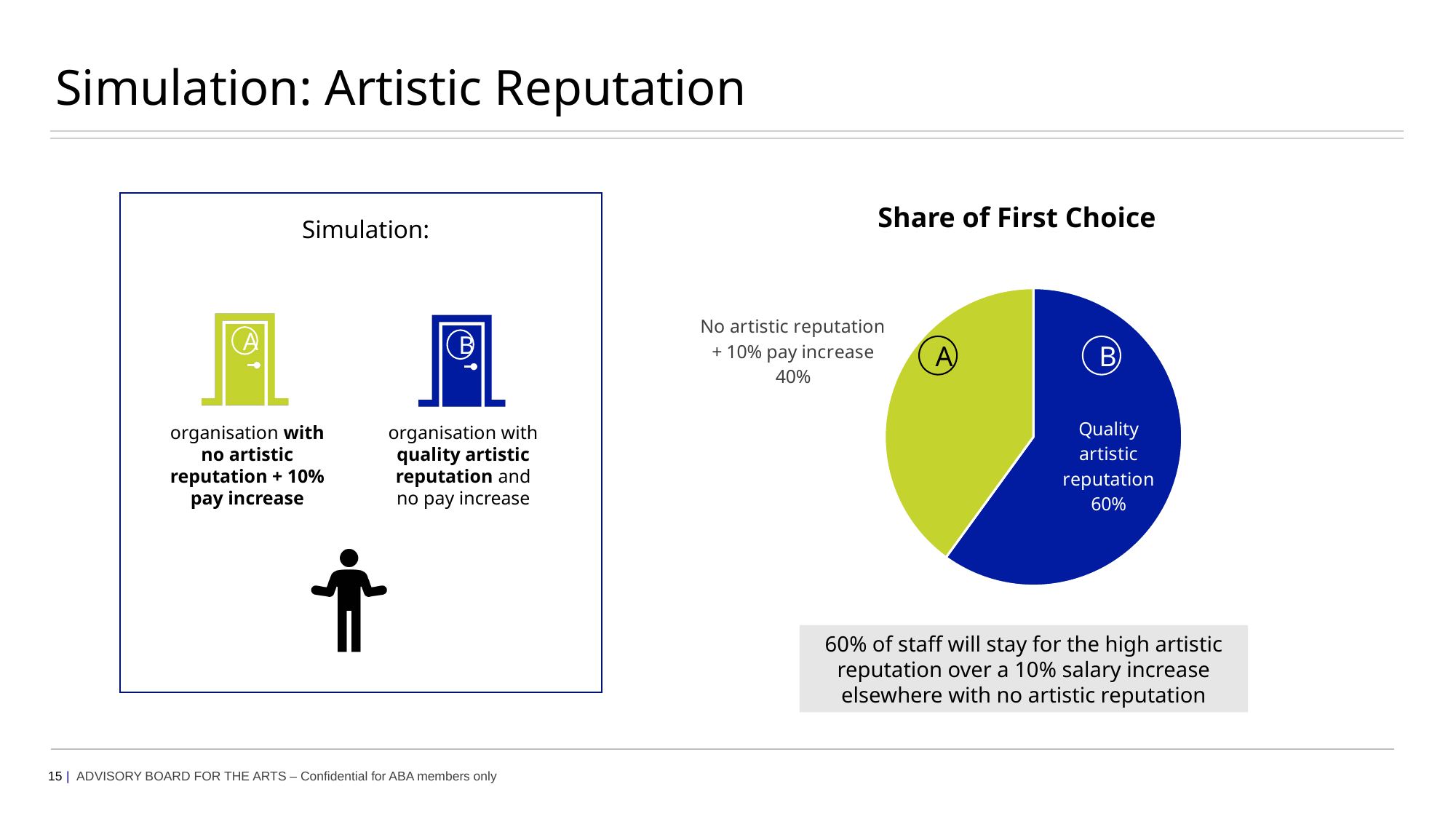
How many slices does the pie chart have? 2 What colour is the "Quality artistic reputation" slice in the pie chart? blue Which is larger: the share for "Quality artistic reputation" or the share for "No artistic reputation + 10% pay increase"? Quality artistic reputation Which slice of the pie chart is the largest? Quality artistic reputation What is the difference in percentage points between the "Quality artistic reputation" slice and the "No artistic reputation + 10% pay increase" slice? 20 percentage points What is the title of the pie chart? Share of First Choice Which letter labels the "No artistic reputation + 10% pay increase" slice in the pie chart? A What share of first choice does "No artistic reputation + 10% pay increase" receive? 40% What kind of chart is shown under the title "Share of First Choice"? pie chart Is the share for "Quality artistic reputation" greater or less than 50%? greater Which slice of the pie chart is the smallest? No artistic reputation + 10% pay increase What share of first choice does "Quality artistic reputation" receive? 60%